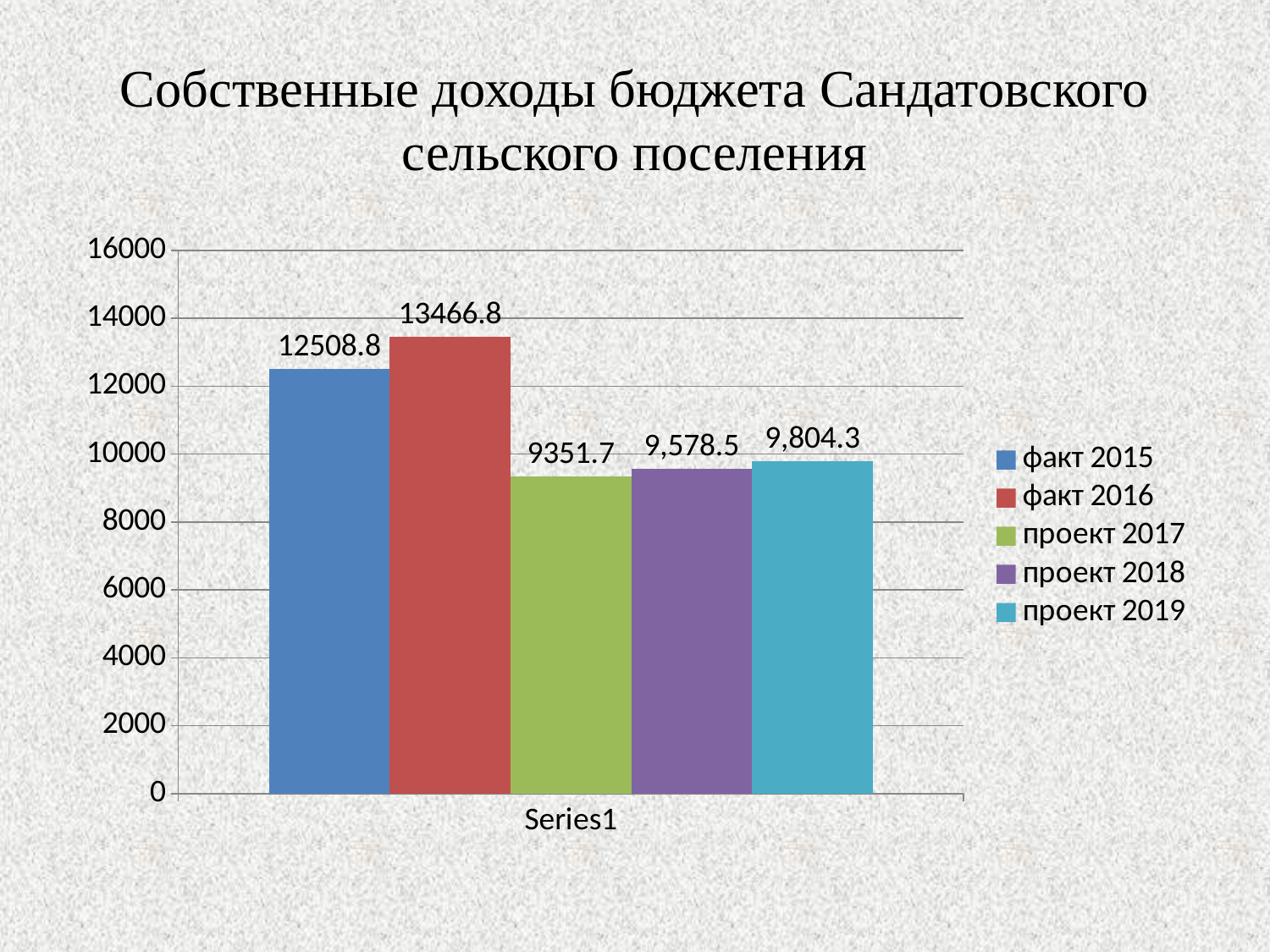
How many series does the legend list? 5 What is the value for факт 2015? 12508.8 Which is larger, the value for факт 2015 or the value for проект 2019? факт 2015 What is the value for факт 2016? 13466.8 Is the value for проект 2018 greater or less than 10000? less What kind of chart is shown on the slide? bar chart Which legend entry has the lowest value? проект 2017 What is the difference between the values for факт 2016 and факт 2015? 958 What is the value for проект 2018? 9,578.5 Which legend entry has the highest value? факт 2016 What is the value for проект 2019? 9,804.3 What is the value for проект 2017? 9351.7